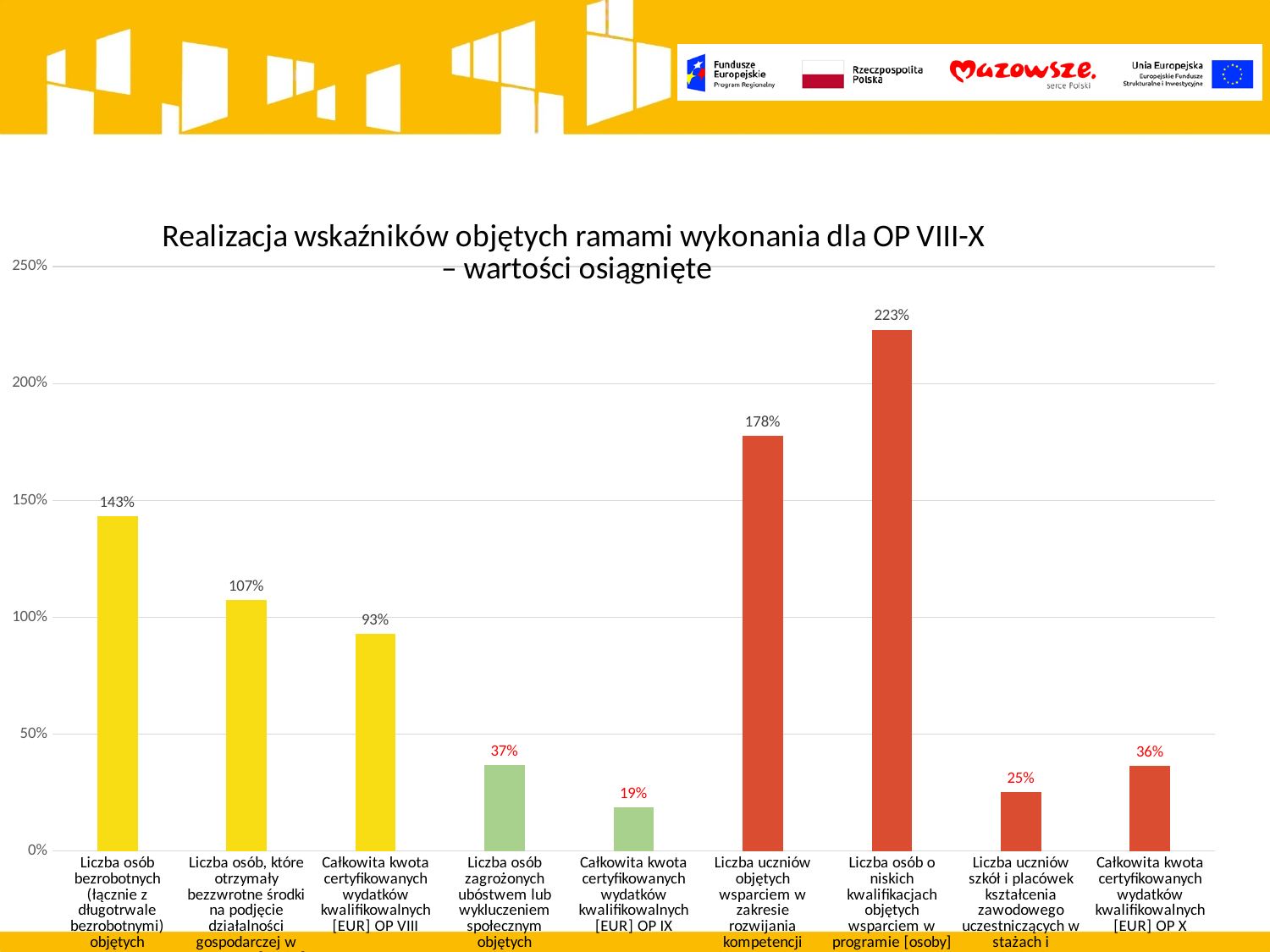
What type of chart is shown on the slide? bar chart What is the value for "Całkowita kwota certyfikowanych wydatków kwalifikowalnych [EUR] OP IX"? 19% Which category has the highest value? Liczba osób o niskich kwalifikacjach objętych wsparciem w programie [osoby] What is the value for "Całkowita kwota certyfikowanych wydatków kwalifikowalnych [EUR] OP VIII"? 93% How many categories (bars) are shown in the chart? 9 Which is larger: the value for "Liczba osób bezrobotnych (łącznie z długotrwale bezrobotnymi)" or the value for "Liczba osób, które otrzymały bezzwrotne środki na podjęcie działalności gospodarczej"? Liczba osób bezrobotnych (łącznie z długotrwale bezrobotnymi) What is the value for "Całkowita kwota certyfikowanych wydatków kwalifikowalnych [EUR] OP X"? 36% What is the value for "Liczba osób o niskich kwalifikacjach objętych wsparciem w programie [osoby]"? 223% What is the title of the chart? Realizacja wskaźników objętych ramami wykonania dla OP VIII-X – wartości osiągnięte Which category has the lowest value? Całkowita kwota certyfikowanych wydatków kwalifikowalnych [EUR] OP IX What is the difference between the value for "Liczba osób o niskich kwalifikacjach objętych wsparciem w programie [osoby]" and the value for "Liczba uczniów objętych wsparciem w zakresie rozwijania kompetencji"? 45% Is the value for "Liczba osób zagrożonych ubóstwem lub wykluczeniem społecznym" greater or less than 50%? less